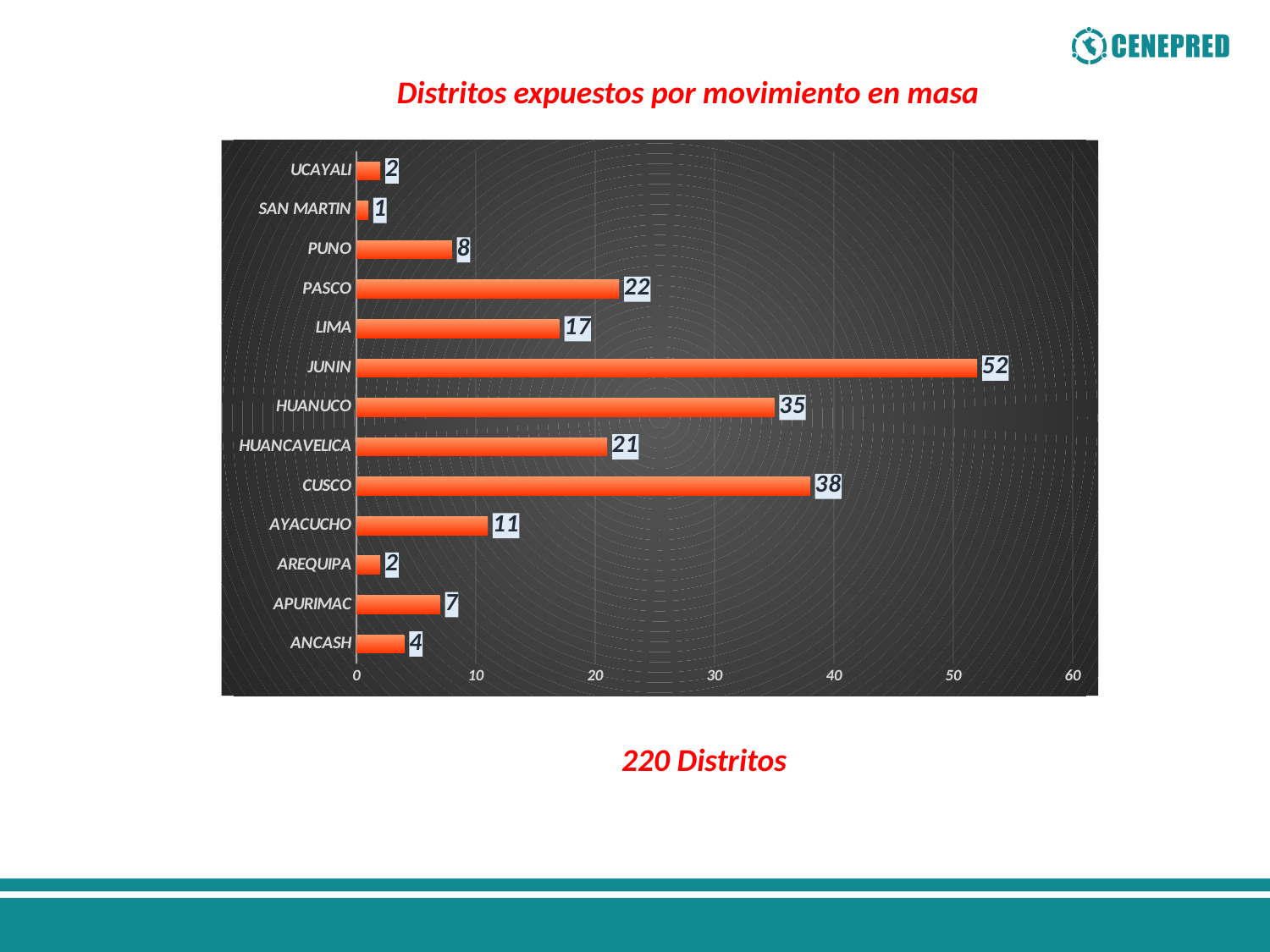
How many regions are shown in the chart? 13 Which region has the highest value? JUNIN What is the title of the chart? Distritos expuestos por movimiento en masa Is the value for AYACUCHO greater or less than 10? greater What kind of chart is shown? bar chart Which has a larger value, PASCO or LIMA? PASCO What is the difference between the values for CUSCO and HUANUCO? 3 Which region has the lowest value? SAN MARTIN What is the value for HUANCAVELICA? 21 What is the value for JUNIN? 52 What is the value for APURIMAC? 7 What is the total number of districts stated below the chart? 220 Distritos